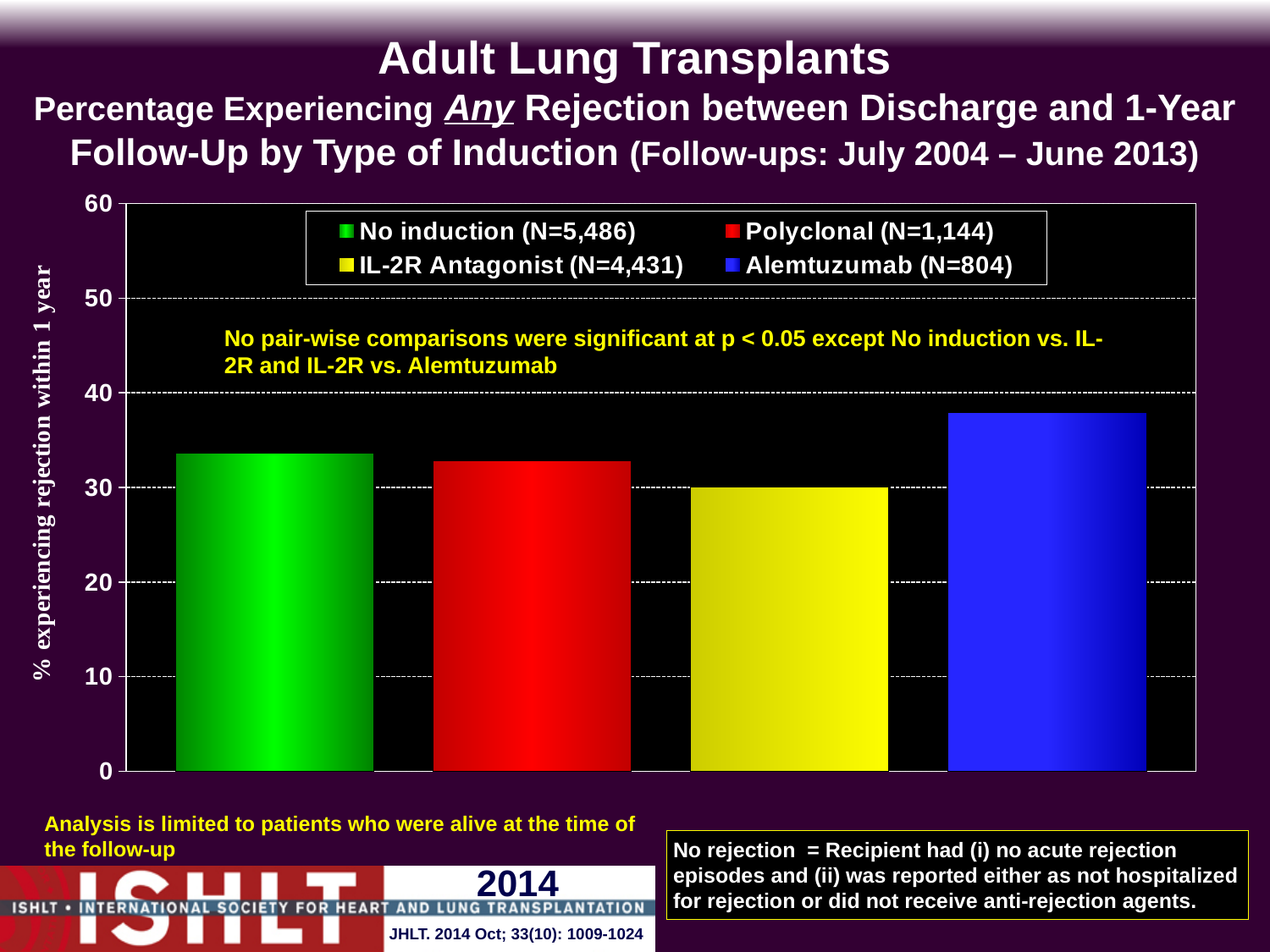
Is the value for Alemtuzumab greater or less than 30? greater According to the legend, what is the N for the No induction group? 5,486 Is the value for Polyclonal greater or less than 40? less Which has a higher percentage experiencing rejection: Alemtuzumab or IL-2R Antagonist? Alemtuzumab Is the value for No induction greater or less than 30? greater Which induction type has the lowest percentage experiencing rejection within 1 year? IL-2R Antagonist How many series does the legend list? 4 Which has a higher percentage experiencing rejection: Alemtuzumab or No induction? Alemtuzumab Which induction type has the highest percentage experiencing rejection within 1 year? Alemtuzumab How many bars (induction types) are plotted in the chart? 4 What kind of chart is shown on the slide? bar chart